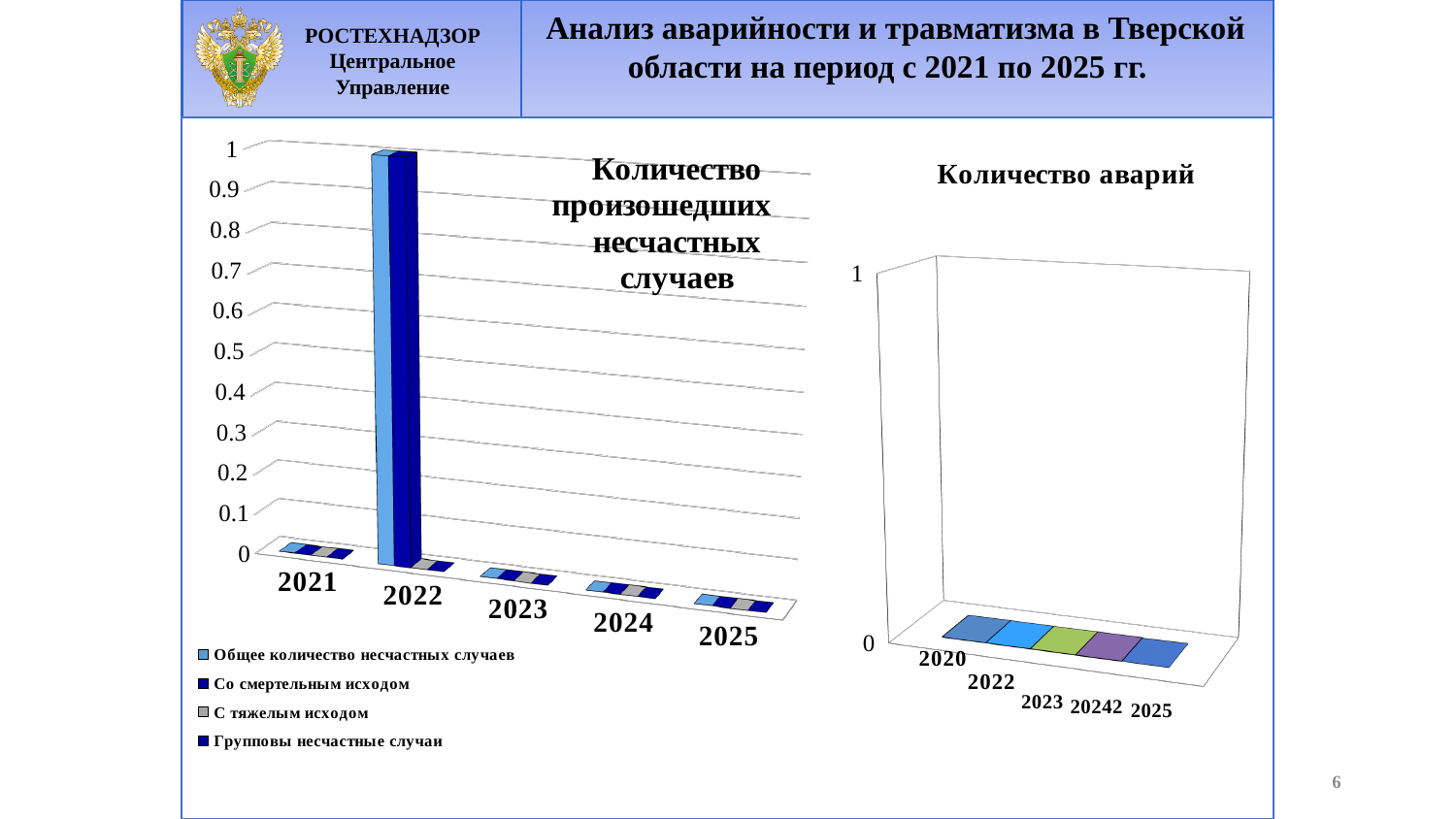
In the left chart "Количество произошедших несчастных случаев", which year has the larger value for "Общее количество несчастных случаев": 2021 or 2022? 2022 In the left chart "Количество произошедших несчастных случаев", is the value of "Общее количество несчастных случаев" for 2022 greater or less than 0.5? greater How many series does the legend of the left chart "Количество произошедших несчастных случаев" list? 4 In the right chart "Количество аварий", what is the value for 2023? 0 How many categories are shown on the x axis of the right chart "Количество аварий"? 5 In the left chart "Количество произошедших несчастных случаев", what is the value of "Общее количество несчастных случаев" for 2022? 1 In the left chart "Количество произошедших несчастных случаев", what is the value of "С тяжелым исходом" for 2022? 0 What is the title of the right chart on the slide? Количество аварий In the left chart "Количество произошедших несчастных случаев", what is the value of "Со смертельным исходом" for 2022? 1 How many years are shown on the x axis of the left chart "Количество произошедших несчастных случаев"? 5 In the left chart "Количество произошедших несчастных случаев", which year has the highest value for "Общее количество несчастных случаев"? 2022 What kind of chart is the left chart titled "Количество произошедших несчастных случаев"? bar chart